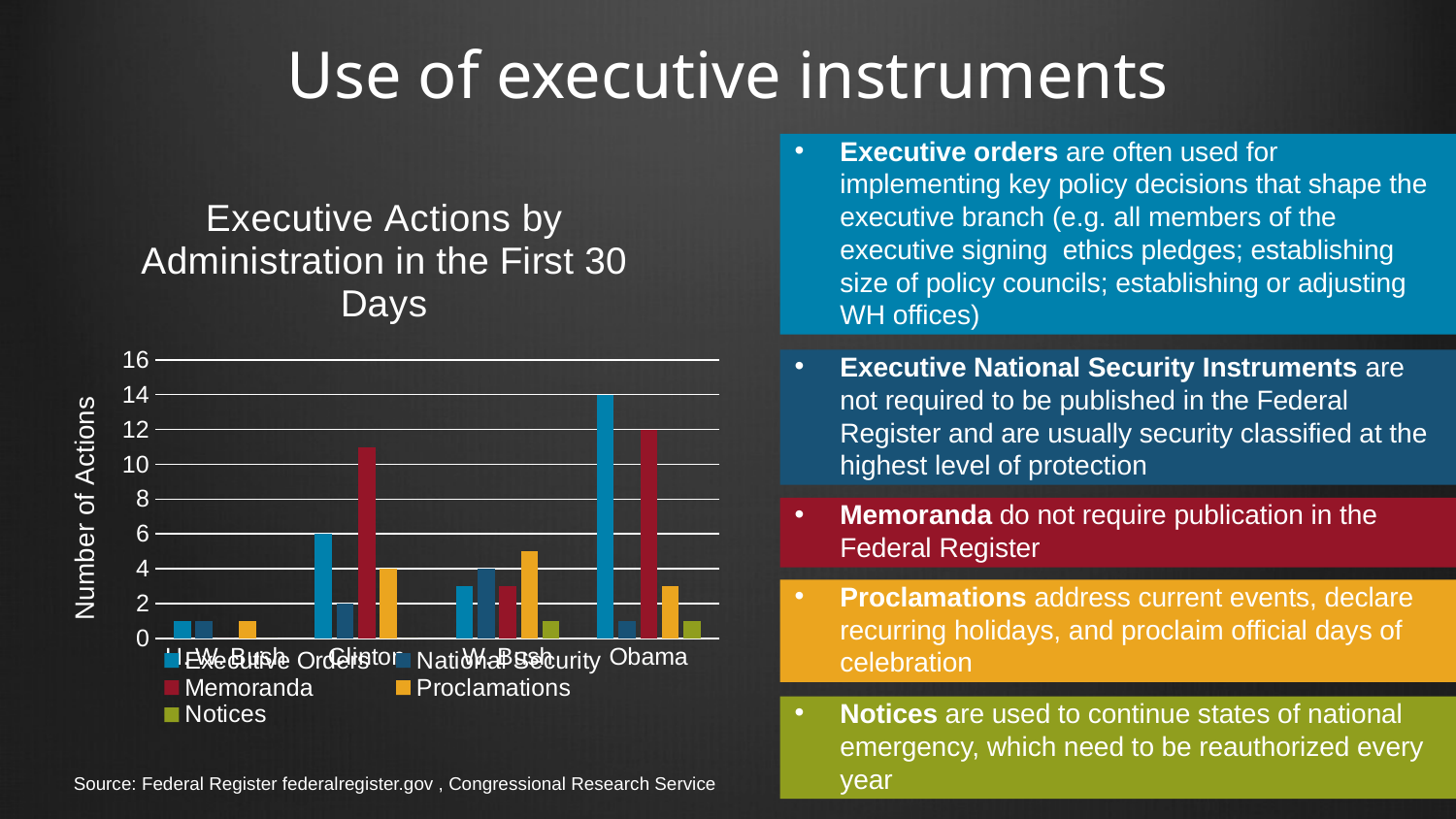
Which administration has the highest number of Executive Orders? Obama How many administrations are shown on the x axis? 4 Is the number of Memoranda for Clinton greater or less than 10? greater How many Memoranda did Obama issue in the first 30 days? 12 What is the difference between Obama's Executive Orders and Obama's Memoranda? 2 What is the title of the chart? Executive Actions by Administration in the First 30 Days What is the label on the y axis? Number of Actions How many Executive Orders did Obama issue in the first 30 days? 14 What kind of chart is shown on the slide? Bar chart How many series does the legend list? 5 Which is larger: Executive Orders for Obama or Executive Orders for Clinton? Obama How many Executive Orders did Clinton issue in the first 30 days? 6